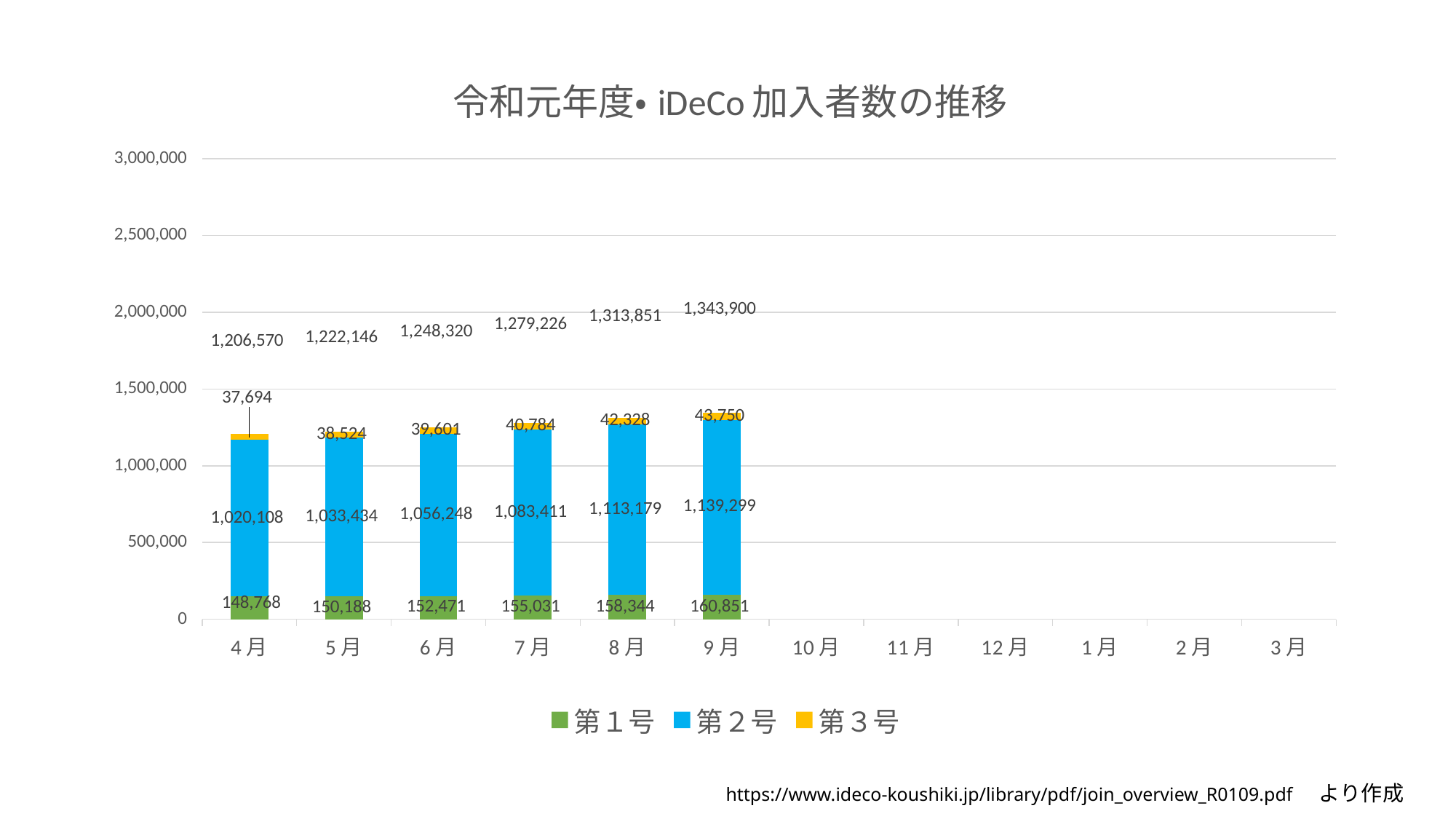
How many series does the legend list? 3 What is the value for 第２号 in 4月? 1,020,108 Do the total values rise or fall from 4月 to 9月? rise What type of chart is shown on the slide? stacked bar chart How many months have data plotted in the chart? 6 Which month has the lowest value for 第２号? 4月 What is the value for 第１号 in 9月? 160,851 What is the total of the stacked bar for 8月? 1,313,851 Which is larger, the 第３号 value in 6月 or in 5月? 6月 Which month has the highest total number of iDeCo participants? 9月 What is the value for 第３号 in 7月? 40,784 What is the difference between the 第１号 values for 9月 and 4月? 12,083